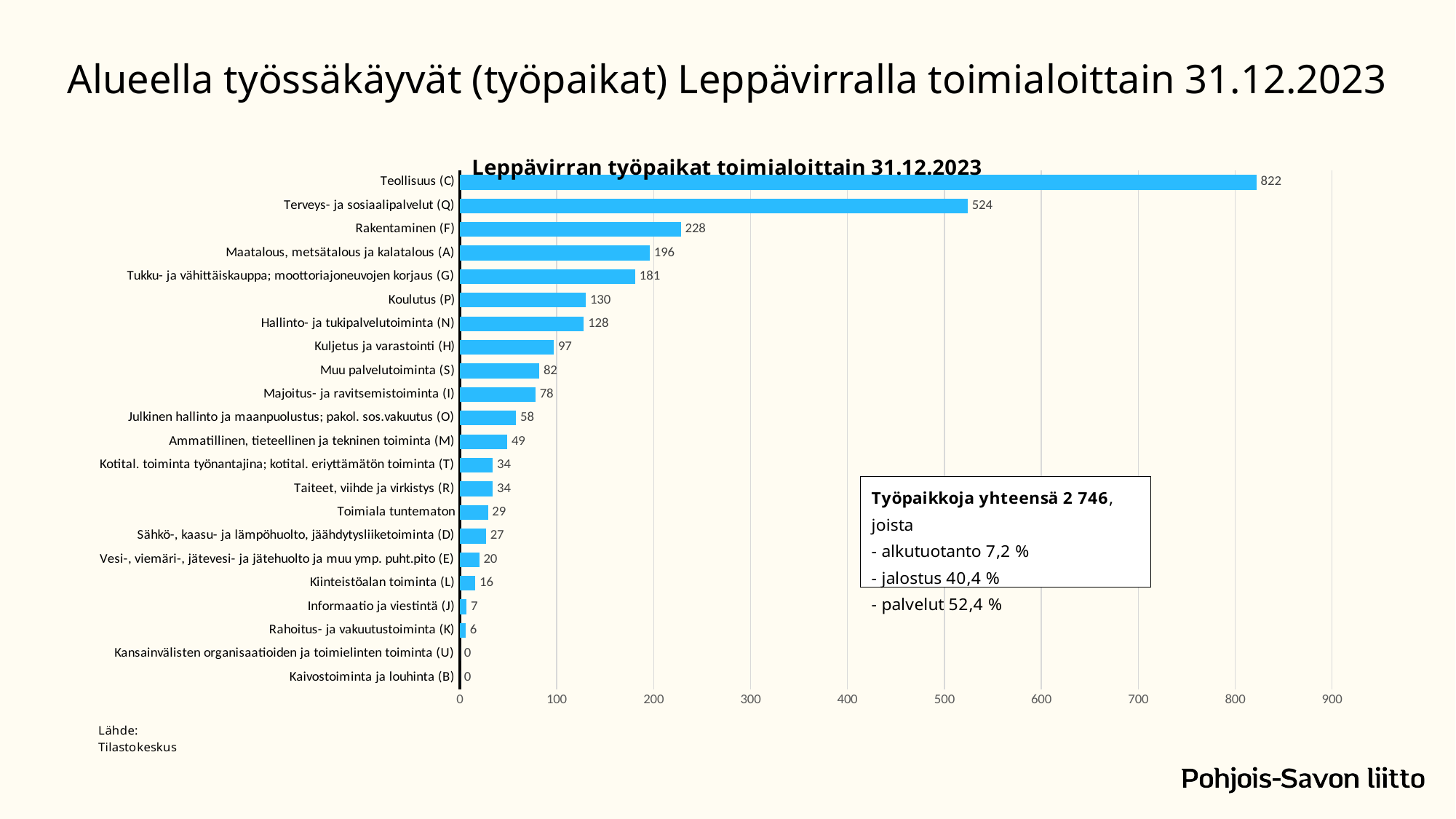
How many categories have a value of 0? 2 Which is larger, Kuljetus ja varastointi (H) or Muu palvelutoiminta (S)? Kuljetus ja varastointi (H) How many categories are shown in the chart? 22 What is the value for Teollisuus (C)? 822 Is the value for Terveys- ja sosiaalipalvelut (Q) greater or less than 500? greater What is the title of the chart? Leppävirran työpaikat toimialoittain 31.12.2023 What is the value for Kiinteistöalan toiminta (L)? 16 What is the value for Koulutus (P)? 130 Which category has the highest value? Teollisuus (C) What is the difference between Teollisuus (C) and Terveys- ja sosiaalipalvelut (Q)? 298 What is the difference between Rakentaminen (F) and Maatalous, metsätalous ja kalatalous (A)? 32 What kind of chart is shown on the slide? bar chart